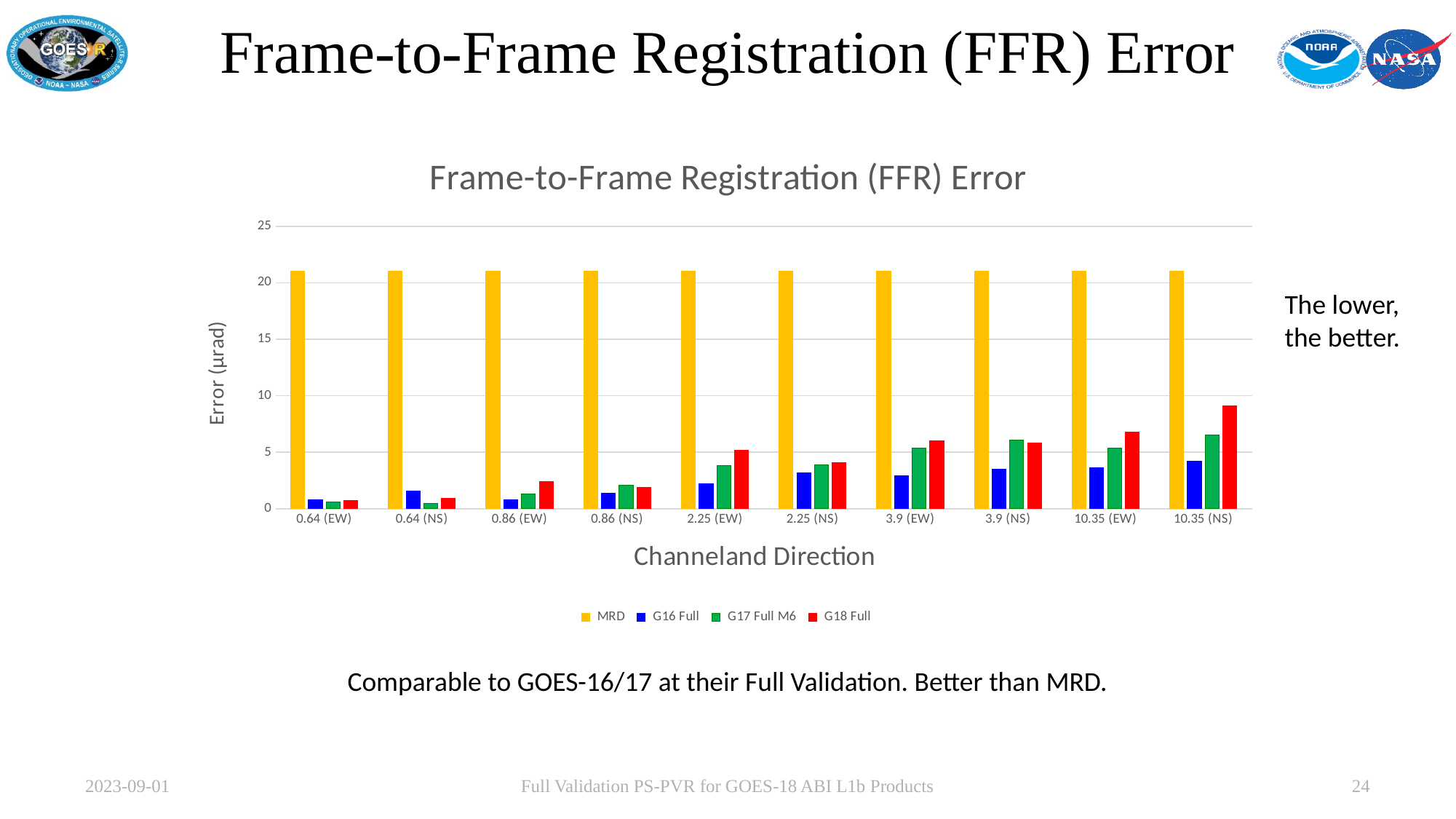
At 0.86 (EW), which is larger: G17 Full M6 or G18 Full? G18 Full How many categories are shown along the x axis? 10 Is the value for G17 Full M6 at 3.9 (NS) greater or less than 5? greater How many series does the legend list? 4 What is the title of the y axis? Error (μrad) At 10.35 (NS), which is larger: G16 Full or G18 Full? G18 Full For which category is the G18 Full value highest? 10.35 (NS) Is the value for MRD at 0.64 (EW) greater or less than 20? greater Which series is shown in yellow? MRD Is the value for G18 Full at 10.35 (NS) greater or less than 10? less What kind of chart is shown on the slide? bar chart